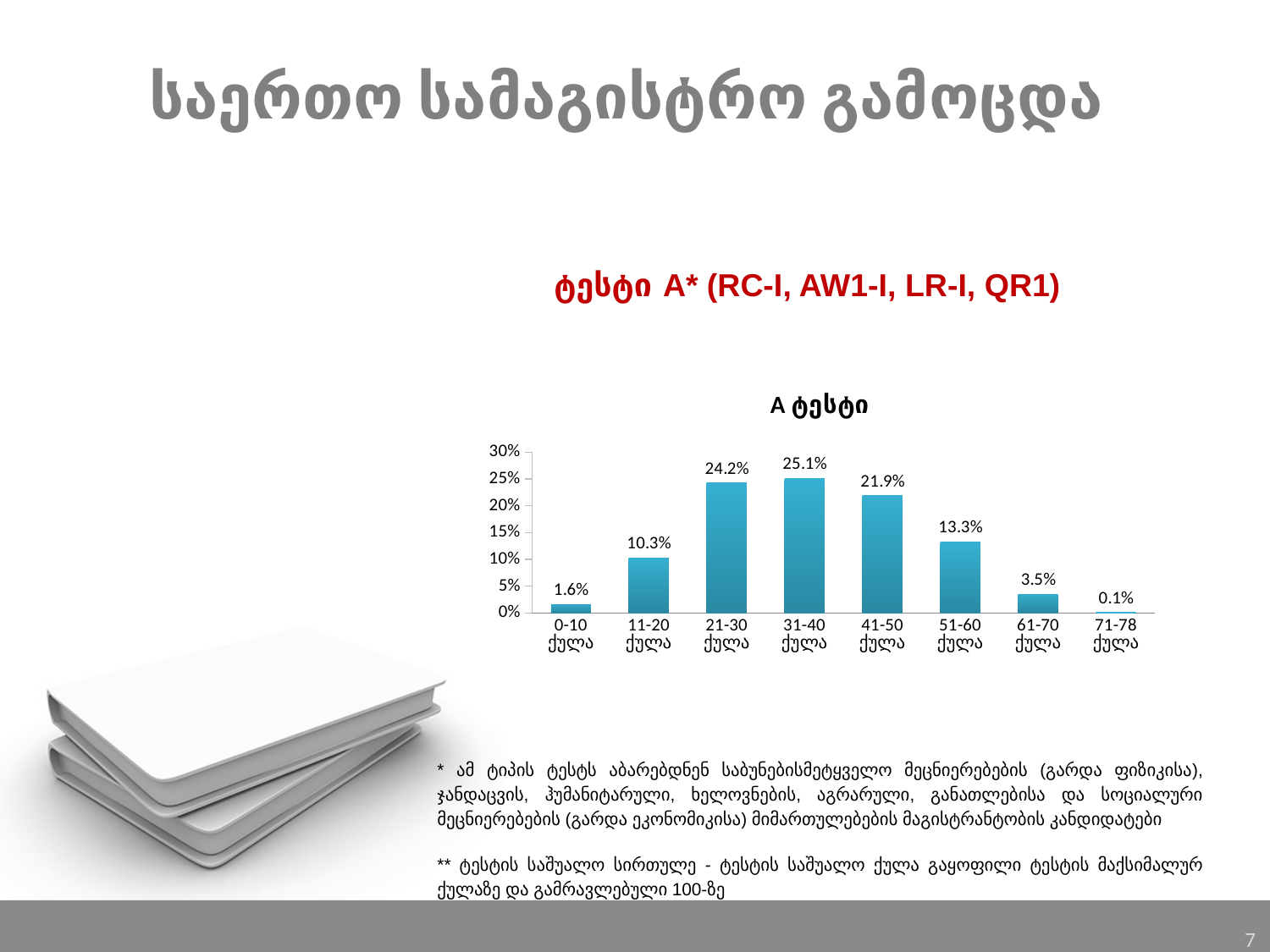
Is the value for 51-60 ქულა greater or less than 15%? less What is the difference between the values for 21-30 ქულა and 51-60 ქულა? 10.9% Which category has the highest value? 31-40 ქულა What is the title of the chart? A ტესტი What is the value for the 11-20 ქულა category? 10.3% How many categories are shown on the x axis? 8 Do the values rise or fall from 31-40 ქულა to 71-78 ქულა? fall What is the value for the 61-70 ქულა category? 3.5% Which is larger, the value for 41-50 ქულა or the value for 11-20 ქულა? 41-50 ქულა What is the value for the 31-40 ქულა category? 25.1% Which category has the lowest value? 71-78 ქულა What kind of chart is shown on the slide? bar chart